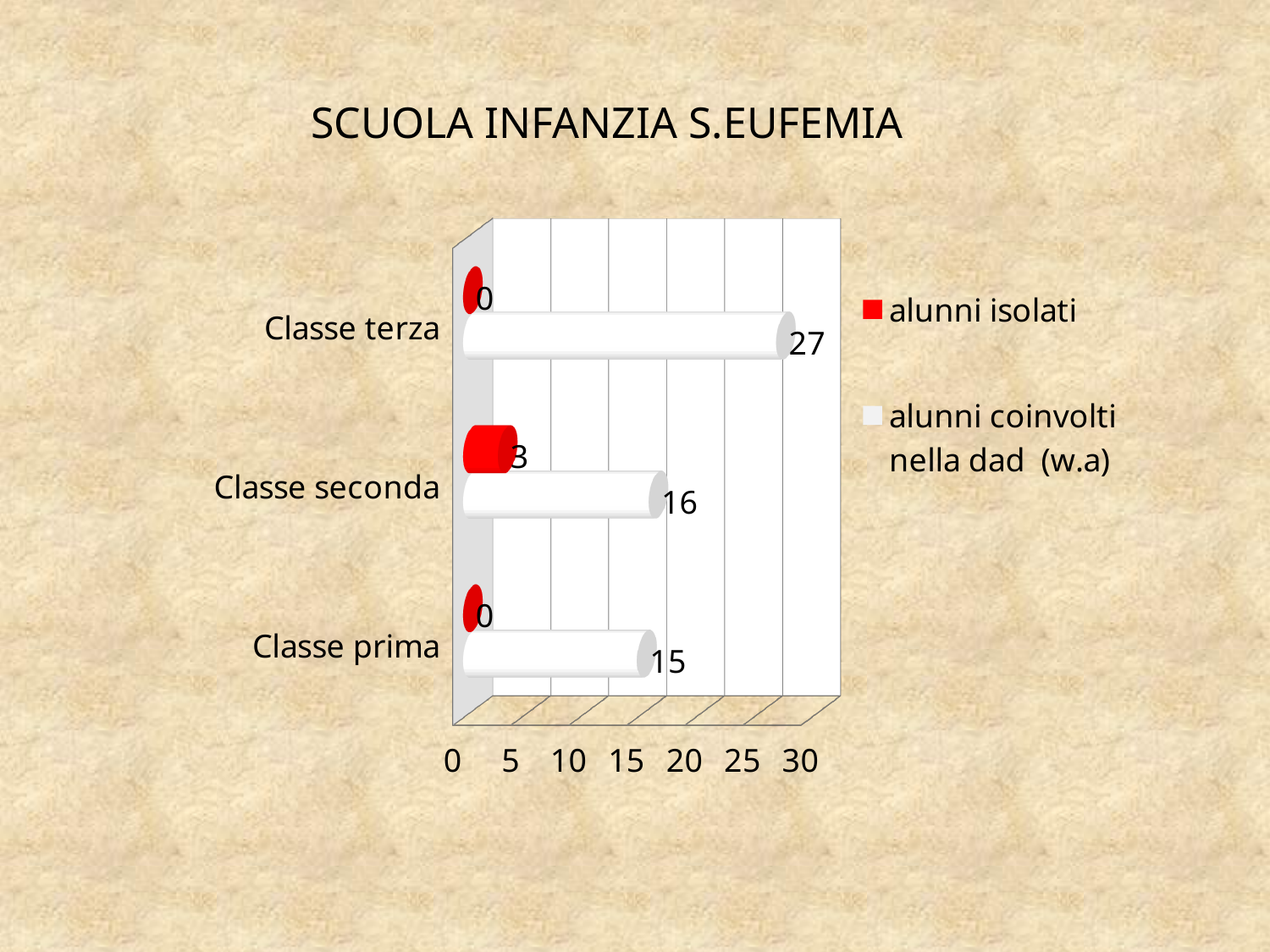
What is the difference between 'alunni coinvolti nella dad (w.a)' for Classe terza and Classe seconda? 11 What is the value of 'alunni isolati' for Classe seconda? 3 What is the value of 'alunni isolati' for Classe terza? 0 What type of chart is shown on the slide? Bar chart Which class has the lowest value for 'alunni coinvolti nella dad (w.a)'? Classe prima How many classes are shown on the chart? 3 Which is larger: 'alunni coinvolti nella dad (w.a)' for Classe seconda or for Classe prima? Classe seconda What is the value of 'alunni coinvolti nella dad (w.a)' for Classe prima? 15 Is the value of 'alunni coinvolti nella dad (w.a)' for Classe terza greater or less than 25? greater What is the value of 'alunni coinvolti nella dad (w.a)' for Classe terza? 27 How many series does the legend list? 2 Which class has the highest value for 'alunni coinvolti nella dad (w.a)'? Classe terza